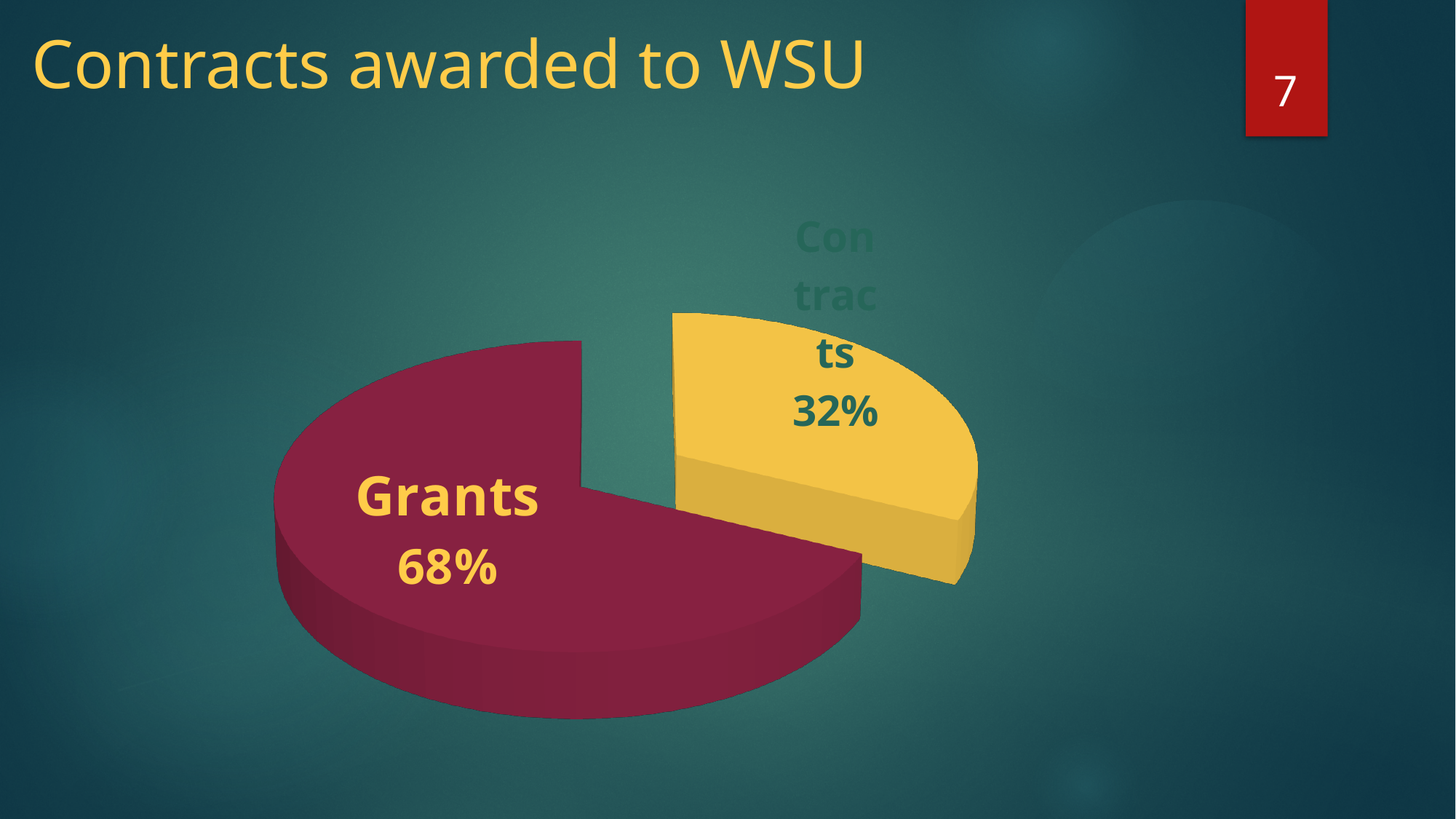
What colour is the Grants slice? Maroon What is the difference in percentage points between the Grants and Contracts slices? 36 What kind of chart is shown on the slide? Pie chart What share of the pie does Contracts represent? 32% Which slice is the smallest? Contracts How many slices does the pie chart have? 2 What share of the pie does Grants represent? 68% What is the title of the slide containing the chart? Contracts awarded to WSU Which is larger, the Grants slice or the Contracts slice? Grants Which slice is the largest? Grants